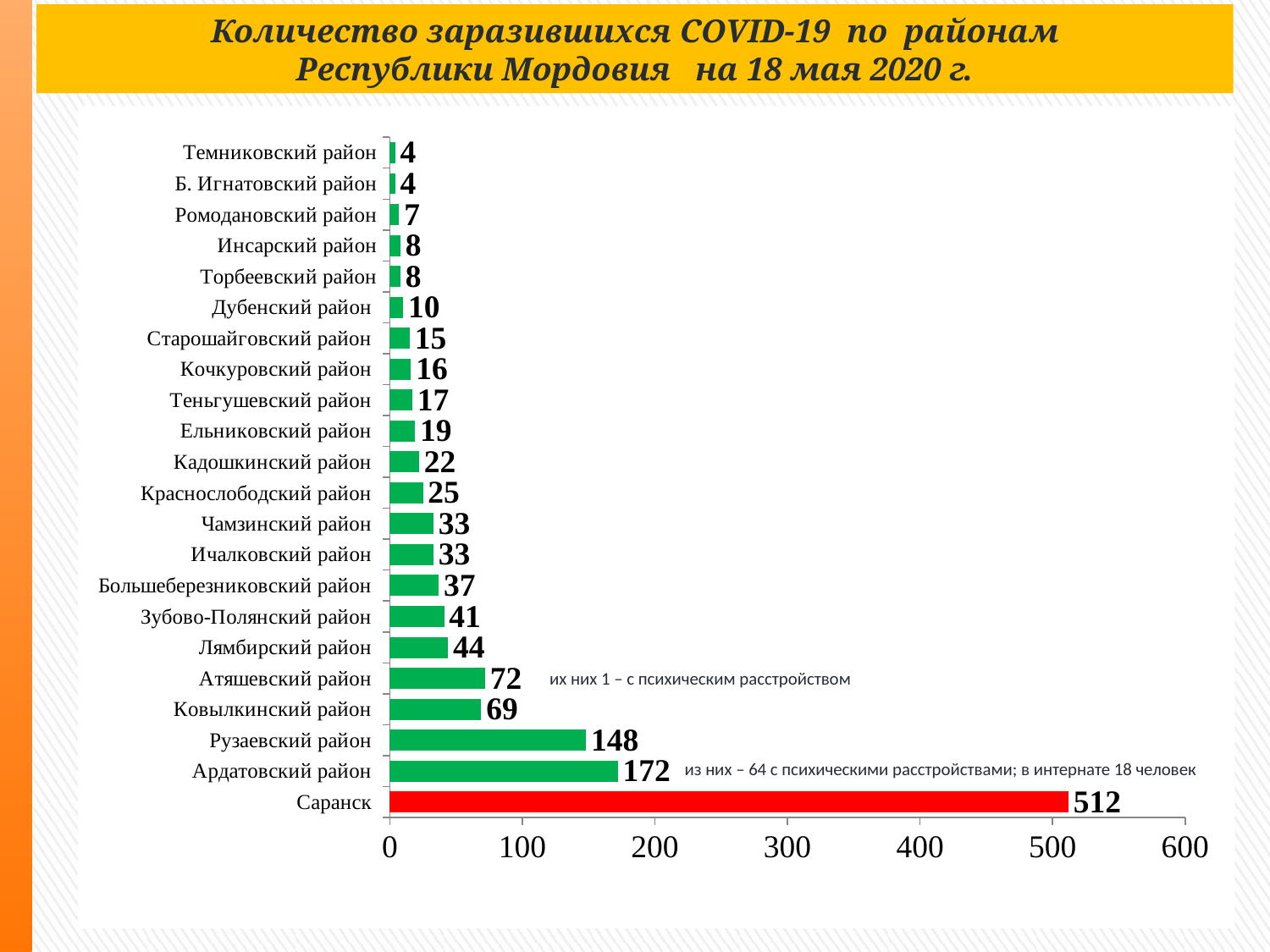
What is the value for Саранск? 512 What is the value for Лямбирский район? 44 What is the value for Ардатовский район? 172 Is the value for Саранск greater or less than 500? greater What is the difference between the values for Ардатовский район and Рузаевский район? 24 What is the value for Рузаевский район? 148 How many categories are shown on the chart? 22 What colour is the bar for Саранск? red What is the difference between the values for Саранск and Ардатовский район? 340 Which is larger, the value for Атяшевский район or Ковылкинский район? Атяшевский район Which category has the highest value? Саранск What kind of chart is shown on the slide? bar chart